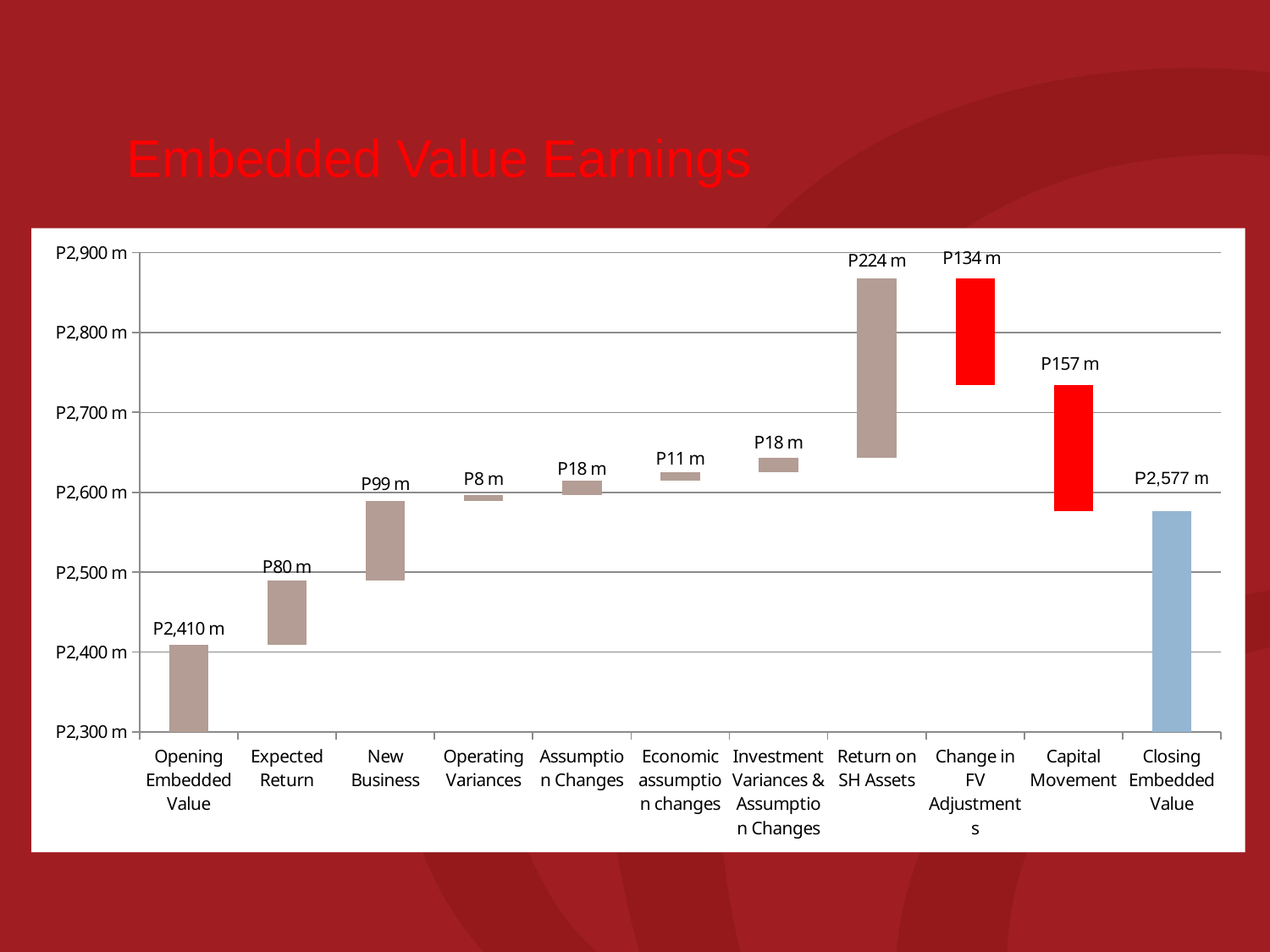
What is the value labelled for New Business? P99 m What colour is the bar for Closing Embedded Value? Blue Which category has the smallest labelled value? Operating Variances Is the Closing Embedded Value greater or less than P2,500 m? greater How many categories are shown on the x axis? 11 Which is larger, the value for Capital Movement or the value for Change in FV Adjustments? Capital Movement Which of the intermediate movement items (excluding the opening and closing values) has the largest labelled value? Return on SH Assets What is the value labelled for Return on SH Assets? P224 m What is the title of the slide containing the chart? Embedded Value Earnings What is the value shown for Opening Embedded Value? P2,410 m What is the value shown for Closing Embedded Value? P2,577 m What is the difference between the Closing Embedded Value and the Opening Embedded Value? P167 m